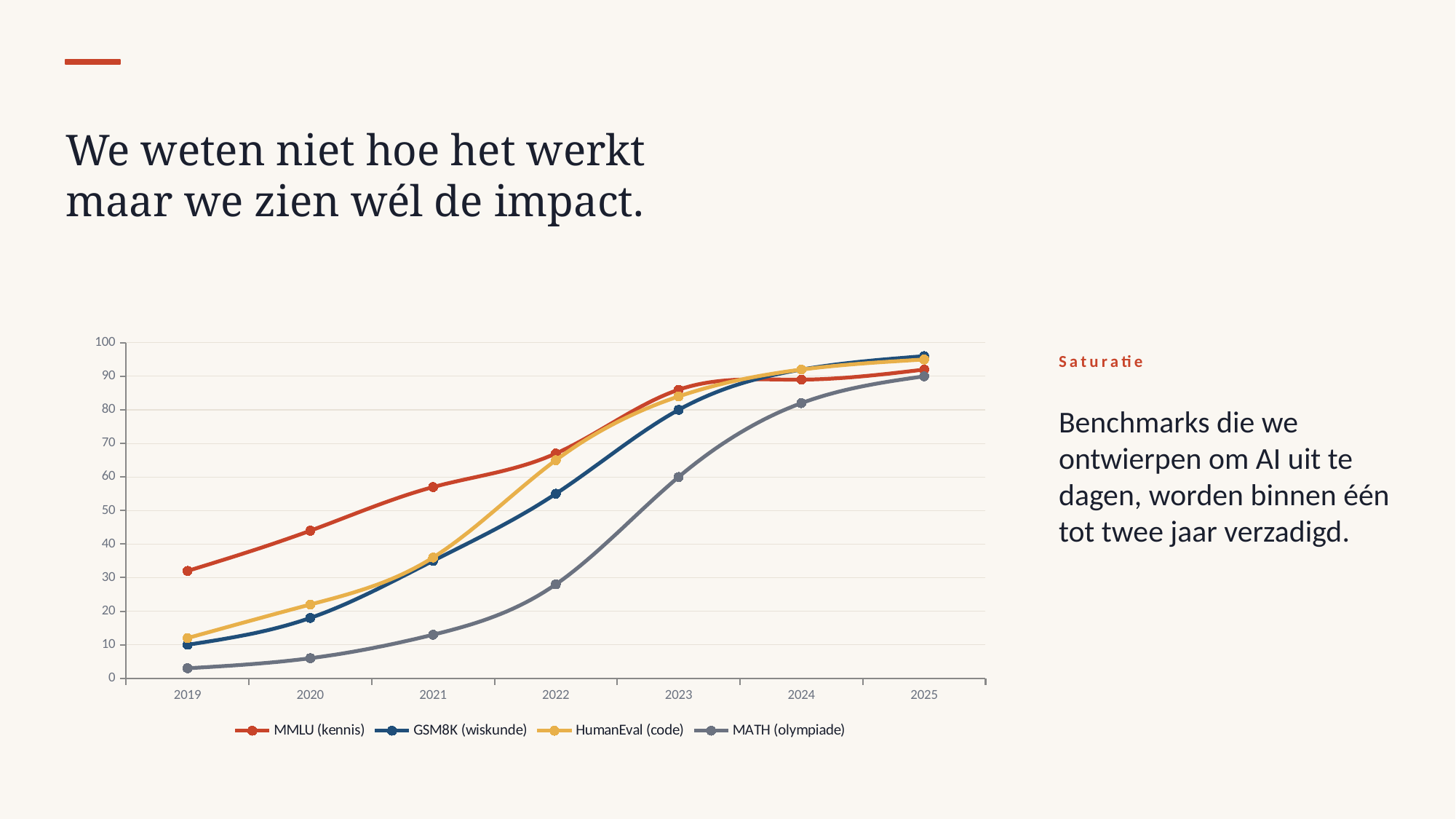
Which series has the highest value in 2019? MMLU (kennis) Does the MATH (olympiade) series rise or fall from 2019 to 2025? rise Is the value for HumanEval (code) in 2021 greater or less than 40? less Is the value for GSM8K (wiskunde) in 2022 greater or less than 50? greater Which series has the lowest value in 2019? MATH (olympiade) Is the value for MATH (olympiade) in 2019 greater or less than 10? less What kind of chart is shown on the slide? line chart What colour is the MMLU (kennis) line? red How many series does the legend list? 4 How many years are shown on the x axis? 7 In 2022, which is larger: HumanEval (code) or MATH (olympiade)? HumanEval (code)